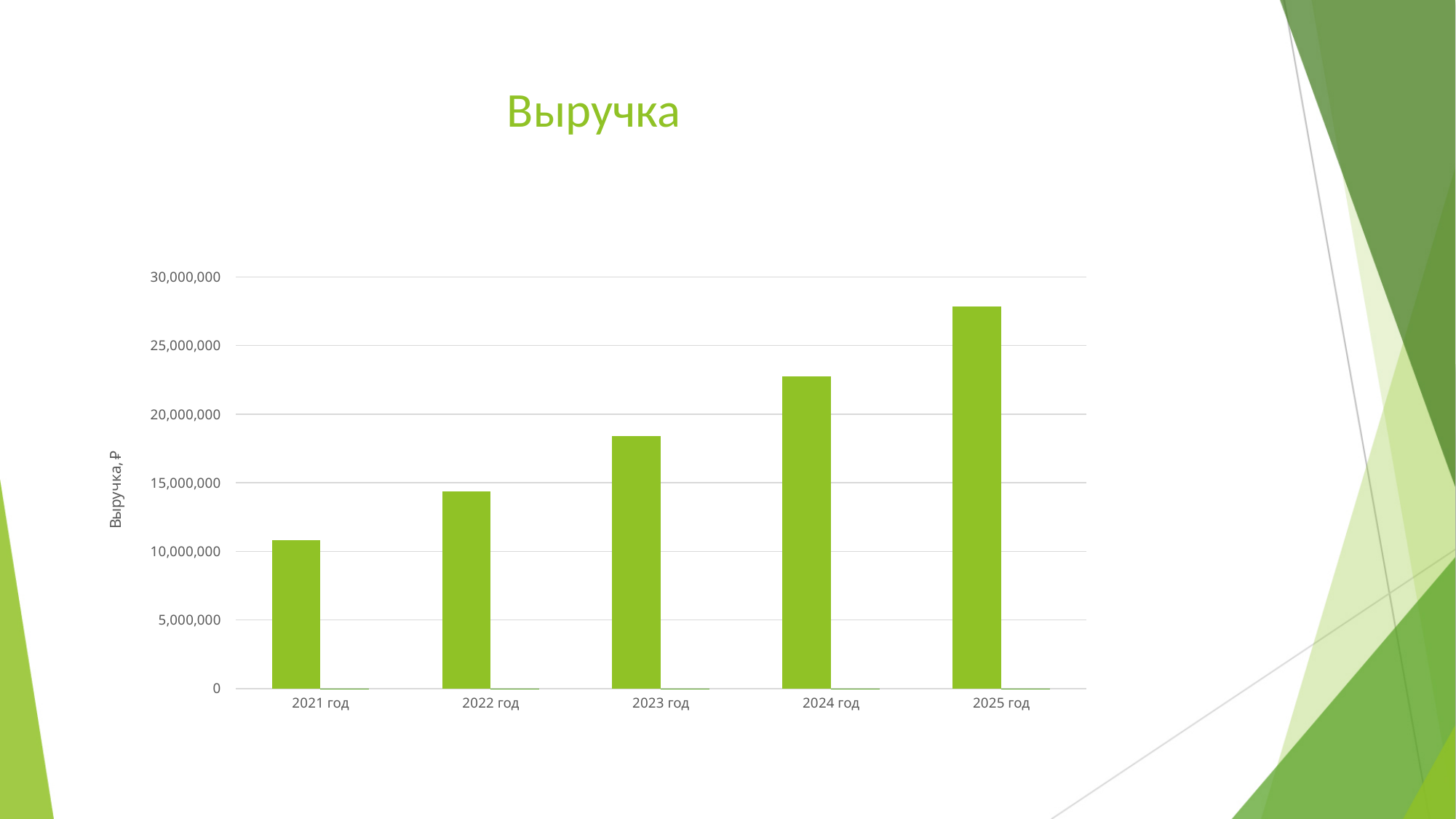
How many years are shown on the x axis of the chart? 5 What kind of chart is shown on the slide? bar chart Is the value for 2021 год greater or less than 10,000,000? greater Do the revenue values rise or fall from 2021 год to 2025 год? rise Which year has the lowest revenue (Выручка) in the chart? 2021 год What is the title of the chart on the slide? Выручка Which is larger, the revenue for 2021 год or for 2022 год? 2022 год Which is larger, the revenue for 2023 год or for 2024 год? 2024 год Which year has the highest revenue (Выручка) in the chart? 2025 год Is the value for 2022 год greater or less than 15,000,000? less Is the value for 2024 год greater or less than 20,000,000? greater